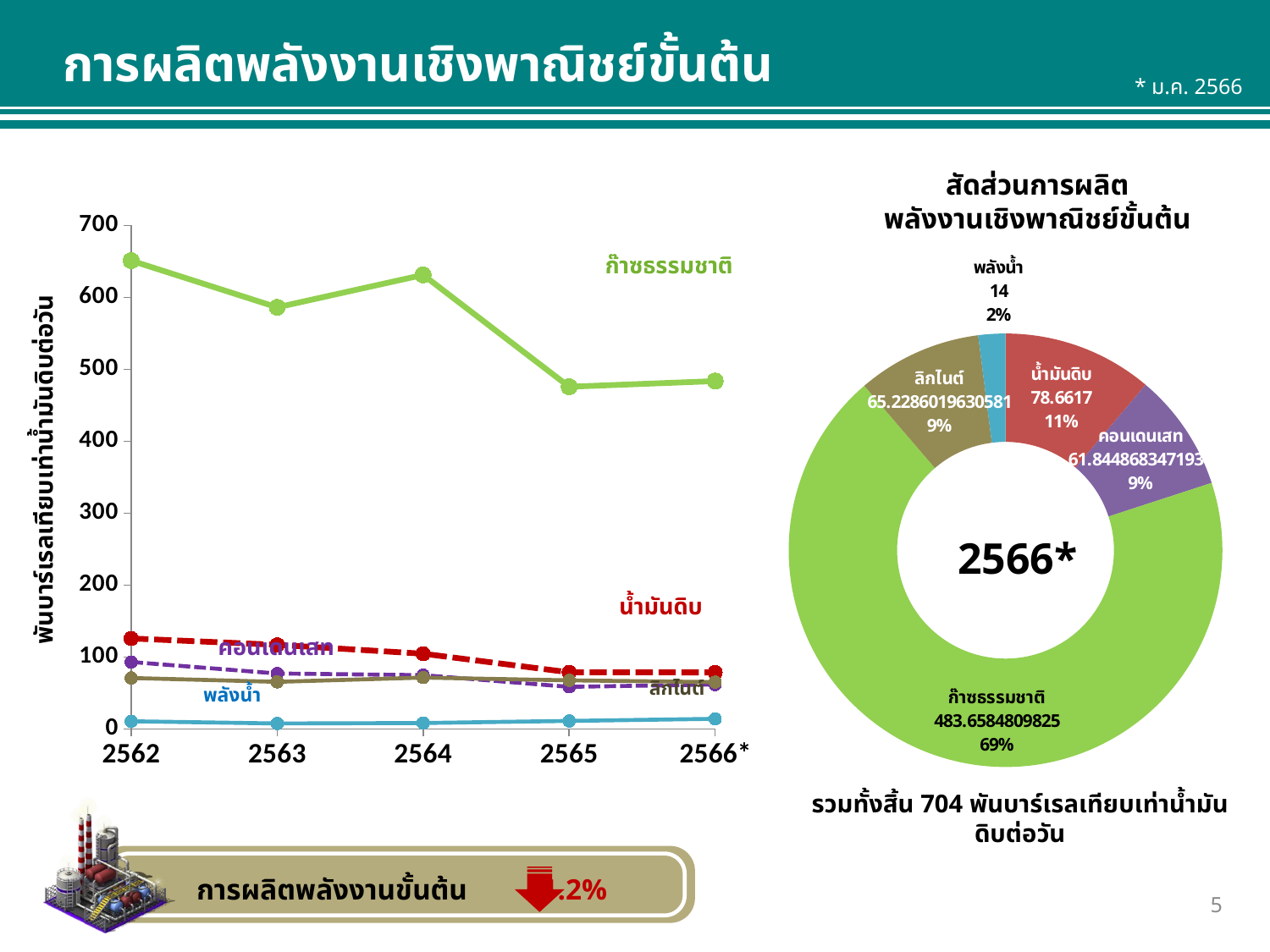
In the line chart on the left, is the value for ก๊าซธรรมชาติ in 2565 greater or less than 500? less In the chart on the right, what percentage share does น้ำมันดิบ have? 11% In the line chart on the left, is the value for ก๊าซธรรมชาติ in 2562 greater or less than 600? greater In the chart on the right, what value is shown for พลังน้ำ? 14 In the chart on the right (สัดส่วนการผลิตพลังงานเชิงพาณิชย์ขั้นต้น), what percentage share does ก๊าซธรรมชาติ have? 69% In the chart on the right, how many categories are shown? 5 In the chart on the right, which category has the smallest share? พลังน้ำ In the chart on the right, what value is shown for น้ำมันดิบ? 78.6617 What kind of chart is the chart on the left? Line chart What kind of chart is the chart on the right? Donut chart In the chart on the right, which category has the largest share? ก๊าซธรรมชาติ In the line chart on the left, which series has the highest values across all years? ก๊าซธรรมชาติ